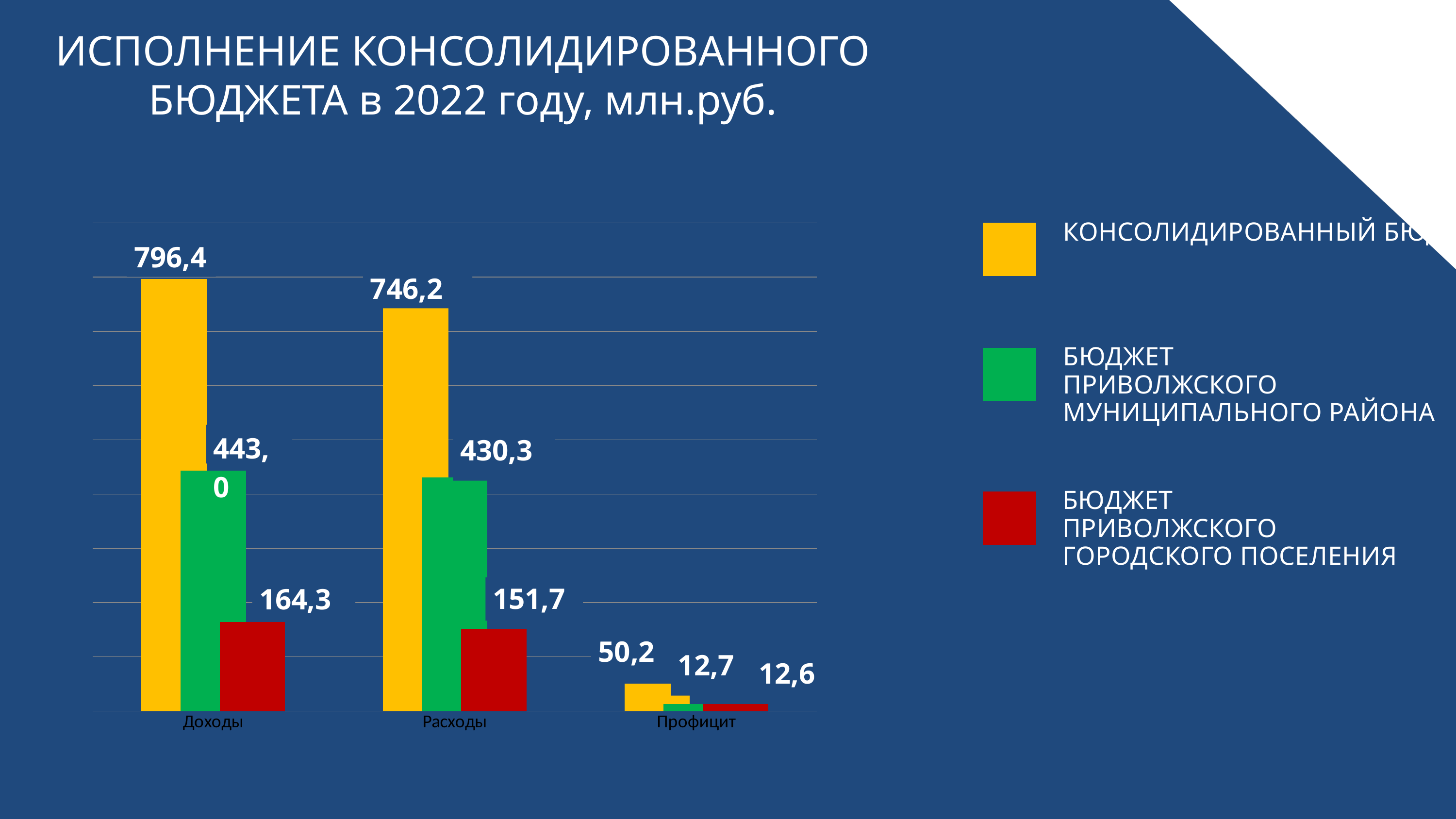
How many categories are shown on the x axis of the chart? 3 What is the value of the consolidated budget (yellow) series for Профицит? 50,2 What type of chart is shown on the slide? bar chart What is the value of the Бюджет Приволжского муниципального района series for Расходы? 430,3 Which category has the highest value for the consolidated budget (yellow) series? Доходы What is the value of the consolidated budget (yellow) series for Доходы? 796,4 Which category has the lowest value for the Бюджет Приволжского муниципального района series? Профицит How many series does the chart's legend list? 3 What is the value of the Бюджет Приволжского городского поселения series for Доходы? 164,3 What is the difference between the consolidated budget values for Доходы and Расходы? 50,2 Which is larger for Расходы: the Бюджет Приволжского муниципального района value or the Бюджет Приволжского городского поселения value? Бюджет Приволжского муниципального района What colour represents the Бюджет Приволжского городского поселения series in the chart? red